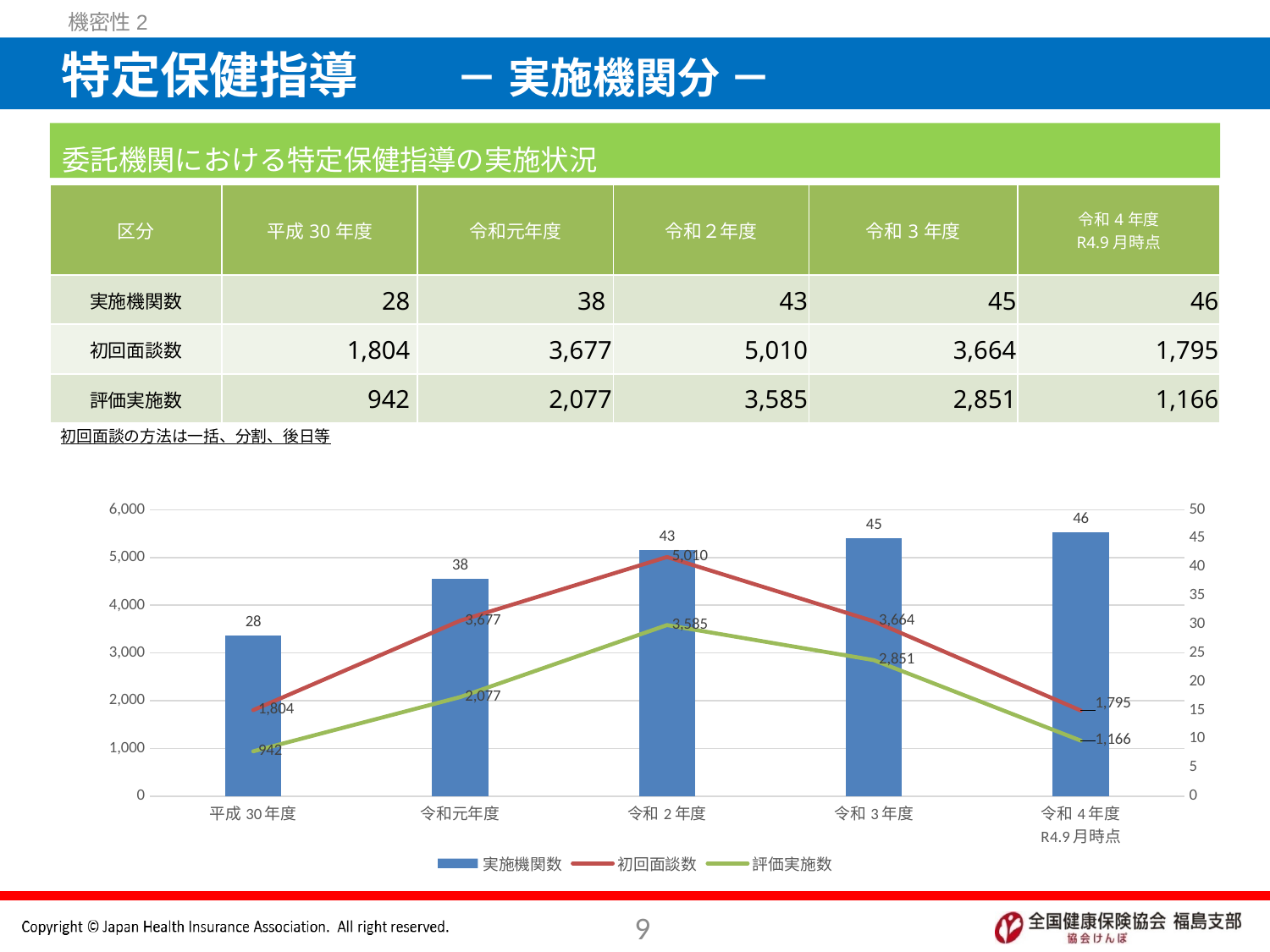
What is the value of 評価実施数 for 平成30年度 in the chart? 942 How many years are shown on the x axis of the chart? 5 Which series in the chart is drawn as bars? 実施機関数 Which is larger in the chart: 初回面談数 for 令和元年度 or 初回面談数 for 令和３年度? 令和元年度 Which year has the highest 初回面談数 in the chart? 令和２年度 How many series does the chart legend list? 3 Which year has the lowest 実施機関数 in the chart? 平成30年度 Does 実施機関数 rise or fall across the years in the chart? Rise What is the difference between 初回面談数 and 評価実施数 for 令和３年度 in the chart? 813 What is the value of 実施機関数 for 令和２年度 in the chart? 43 What kind of chart is shown on the slide? Combined bar and line chart What is the value of 初回面談数 for 令和元年度 in the chart? 3,677